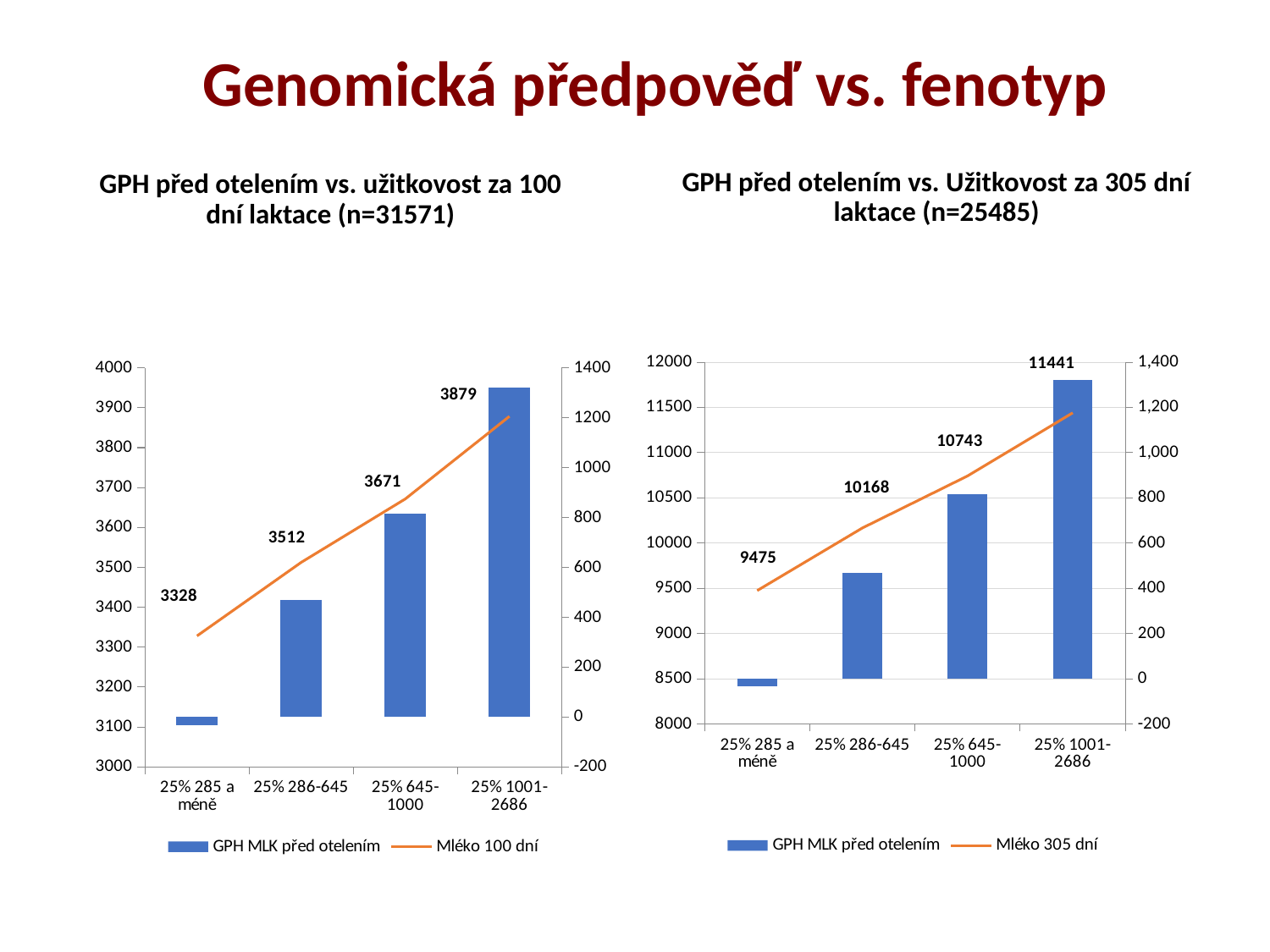
In the left chart (100 dní laktace), what is the Mléko 100 dní value for the category 25% 1001-2686? 3879 In the left chart (GPH před otelením vs. užitkovost za 100 dní laktace), what is the Mléko 100 dní value for the category 25% 285 a méně? 3328 In the right chart (GPH před otelením vs. Užitkovost za 305 dní laktace), what is the Mléko 305 dní value for the category 25% 286-645? 10168 In the left chart (100 dní laktace), what is the difference between the Mléko 100 dní values for 25% 1001-2686 and 25% 285 a méně? 551 In the left chart (100 dní laktace), is the GPH MLK před otelením bar for 25% 1001-2686 greater or less than 1000 on the right-hand axis? greater In the left chart (100 dní laktace), which category has the lowest Mléko 100 dní value? 25% 285 a méně How many categories are shown on the x axis of the left chart (100 dní laktace)? 4 In the right chart (305 dní laktace), is the GPH MLK před otelením bar for 25% 286-645 greater or less than 600 on the right-hand axis? less In the right chart (305 dní laktace), what is the Mléko 305 dní value for the category 25% 645-1000? 10743 In the right chart (305 dní laktace), what is the difference between the Mléko 305 dní values for 25% 1001-2686 and 25% 285 a méně? 1966 In the right chart (305 dní laktace), does the Mléko 305 dní line rise or fall from left to right across the categories? rise In the right chart (305 dní laktace), which category has the highest Mléko 305 dní value? 25% 1001-2686